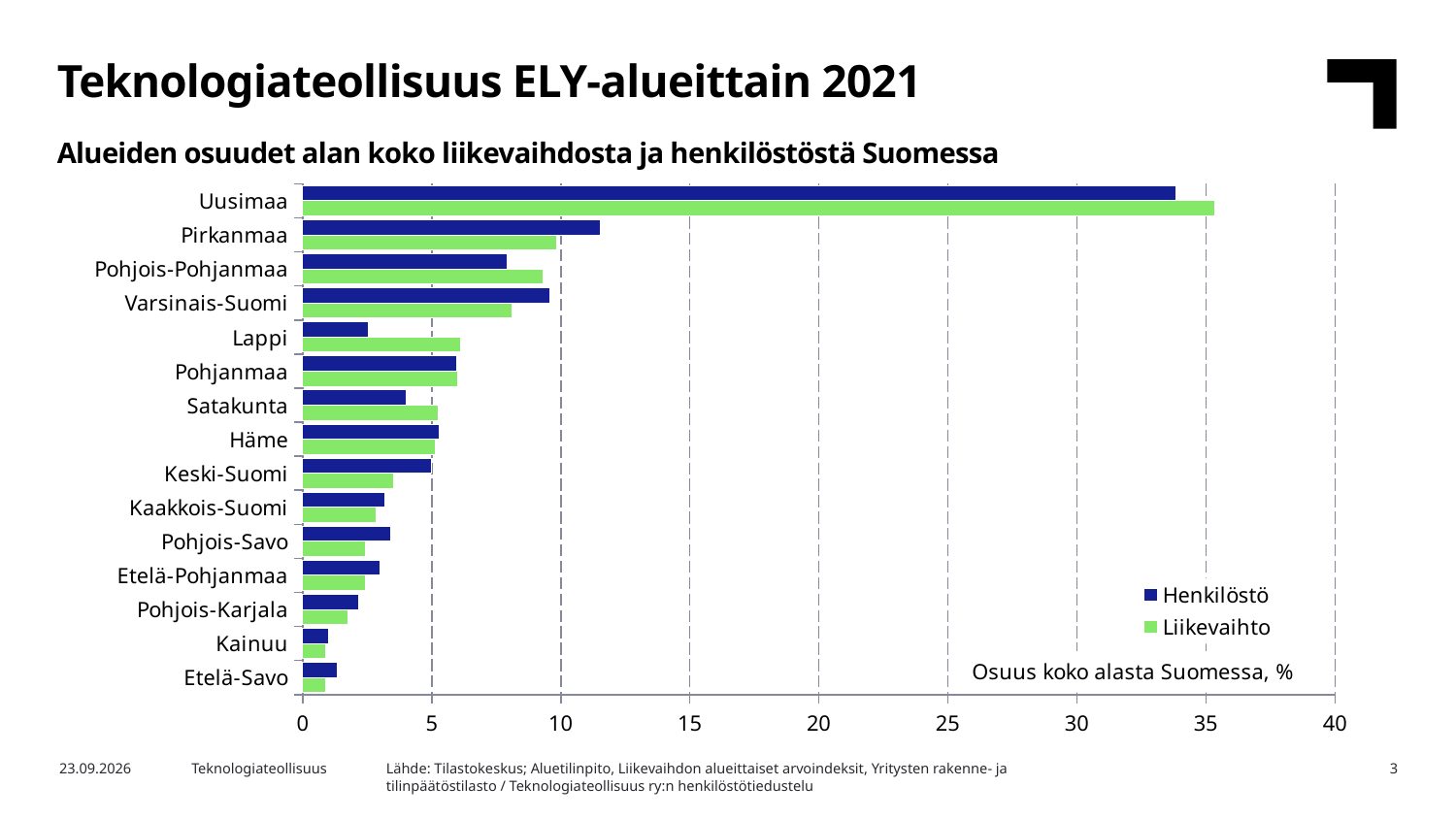
How many regions are shown on the chart? 15 Is the Henkilöstö value for Uusimaa greater or less than 30? greater Which region has the lowest Henkilöstö share? Kainuu What kind of chart is shown on the slide? bar chart Which region has the highest Liikevaihto share? Uusimaa Is the Henkilöstö value for Pirkanmaa greater or less than 10? greater Which series is shown in green? Liikevaihto Which region has the highest Henkilöstö share? Uusimaa Is the Henkilöstö value for Lappi greater or less than 5? less For Pirkanmaa, which is larger: the Henkilöstö share or the Liikevaihto share? Henkilöstö For Lappi, which is larger: the Henkilöstö share or the Liikevaihto share? Liikevaihto How many series does the legend list? 2